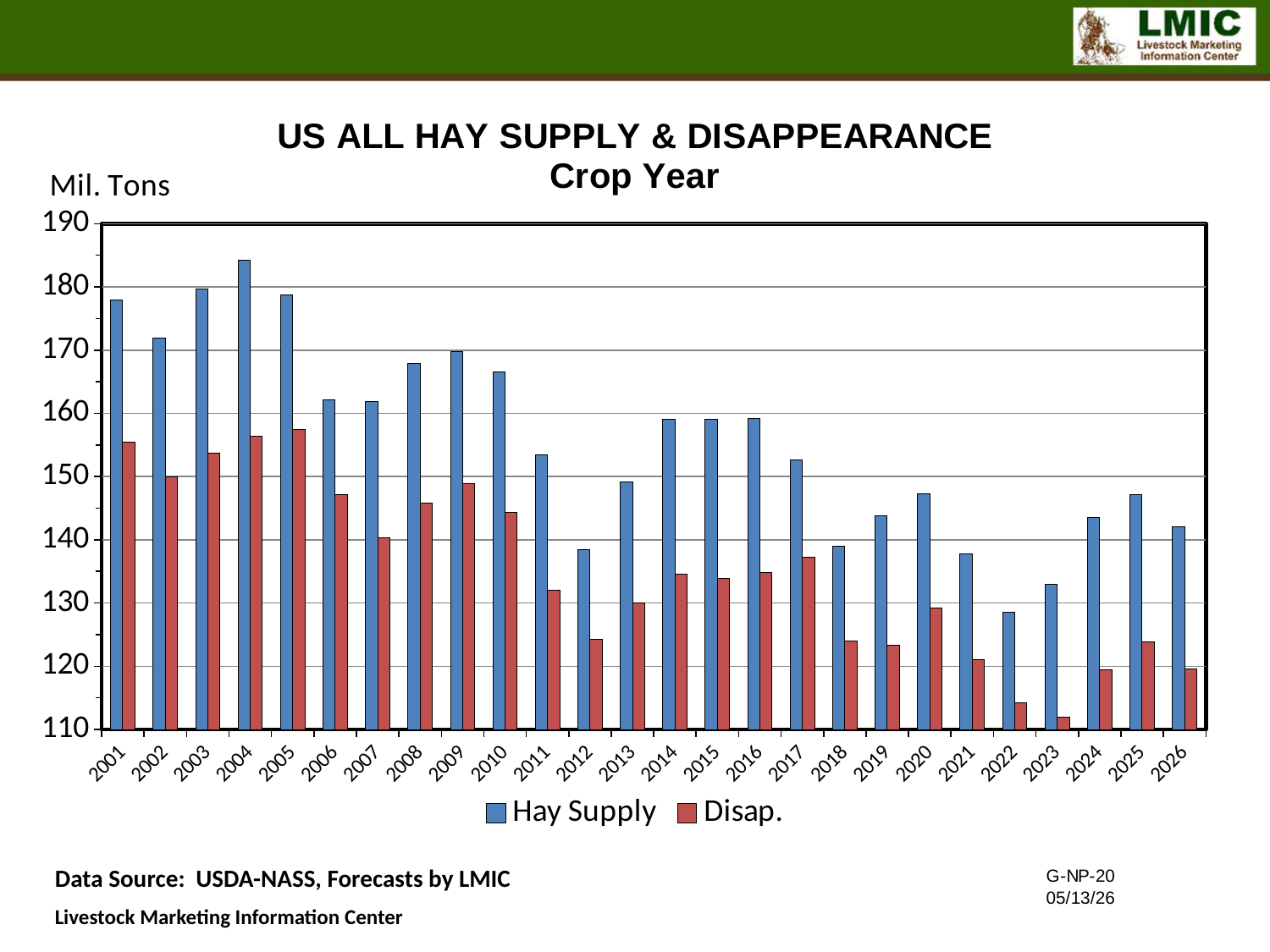
Which crop year has the lowest Hay Supply? 2022 How many series does the legend list? 2 Is the Disap. value for 2001 greater or less than 150? greater Which is larger, the Hay Supply for 2001 or for 2002? 2001 Is the Hay Supply value for 2022 greater or less than 130? less Which crop year has the highest Hay Supply? 2004 Overall, does Hay Supply rise or fall from 2001 to 2026? fall How many crop years are shown on the x axis? 26 Is the Hay Supply value for 2004 greater or less than 180? greater Which is larger, the Disap. value for 2017 or for 2018? 2017 What kind of chart is shown on the slide? bar chart